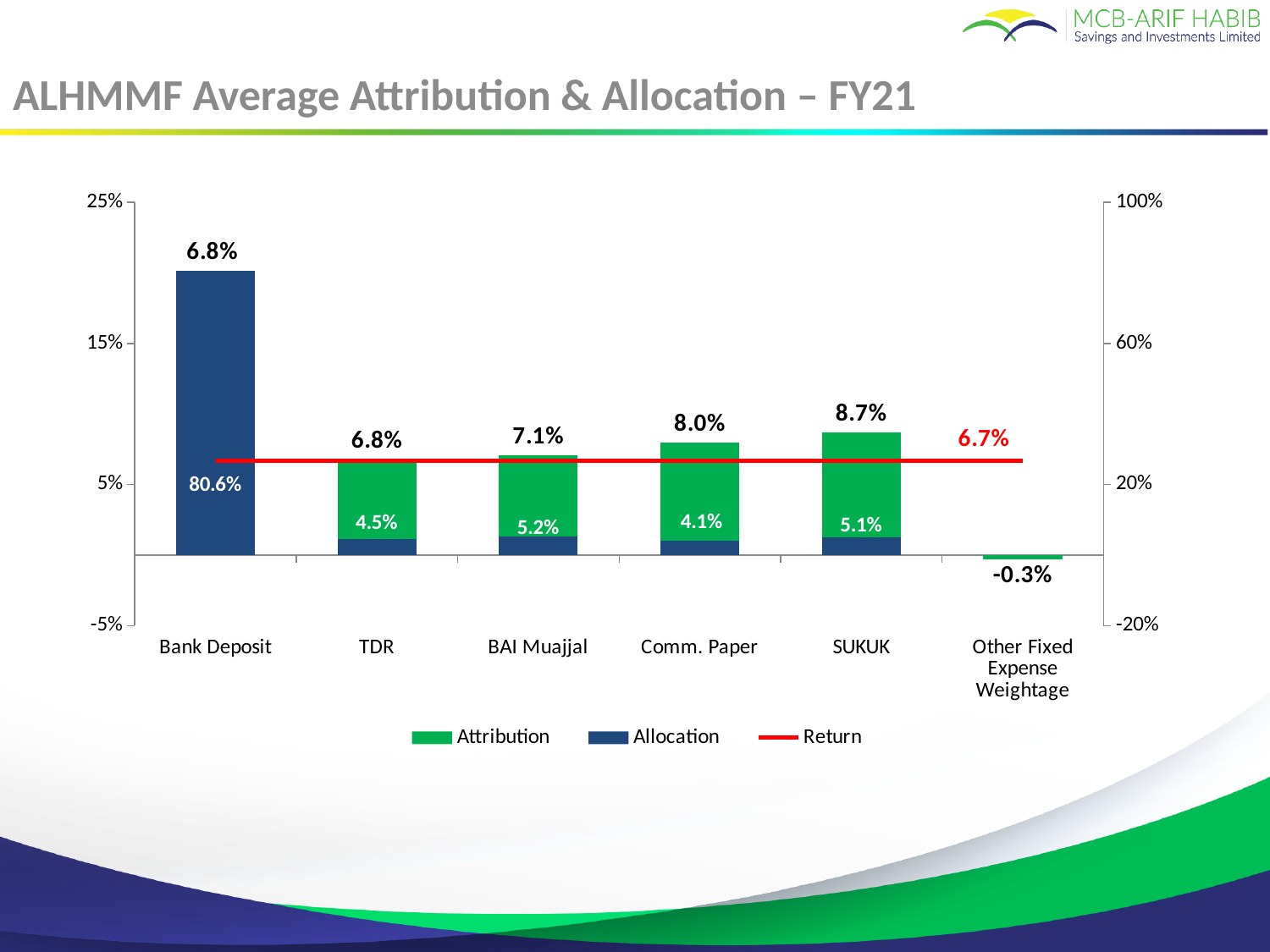
What value is labelled on the Return line? 6.7% What is the Allocation value labelled for Bank Deposit? 80.6% Which category has the lowest Attribution value? Other Fixed Expense Weightage What colour is the Return line in the chart? Red Which has the larger Attribution value, BAI Muajjal or TDR? BAI Muajjal How many categories are shown on the x axis? 6 What kind of chart is shown on the slide? Bar chart with a line What is the Attribution value labelled for SUKUK? 8.7% What is the difference between the Attribution values for SUKUK and Comm. Paper? 0.7% How many series does the legend list? 3 Which category has the highest Attribution value? SUKUK What is the Allocation value labelled for Comm. Paper? 4.1%